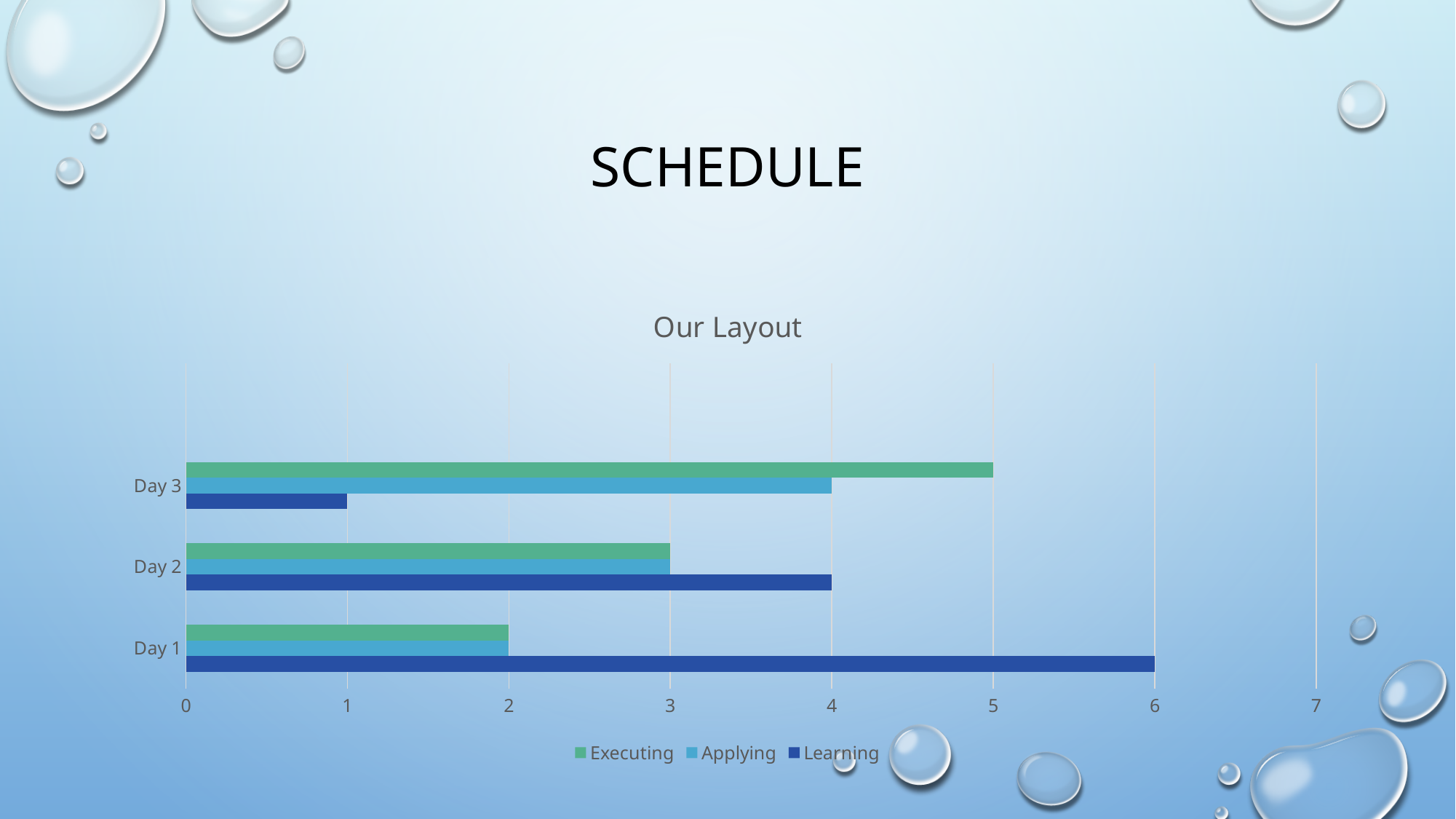
What is the Learning value for Day 1? 6 Which day has the highest Learning value? Day 1 Is the Learning value for Day 2 greater or less than 3? greater What is the title of the chart? Our Layout What kind of chart is shown on the slide? bar chart What is the Applying value for Day 2? 3 Which is larger for Day 3, the Executing value or the Learning value? Executing How many categories are shown on the chart? 3 What is the difference between the Learning values for Day 1 and Day 3? 5 Which day has the lowest Executing value? Day 1 How many series does the legend list? 3 What is the Executing value for Day 3? 5